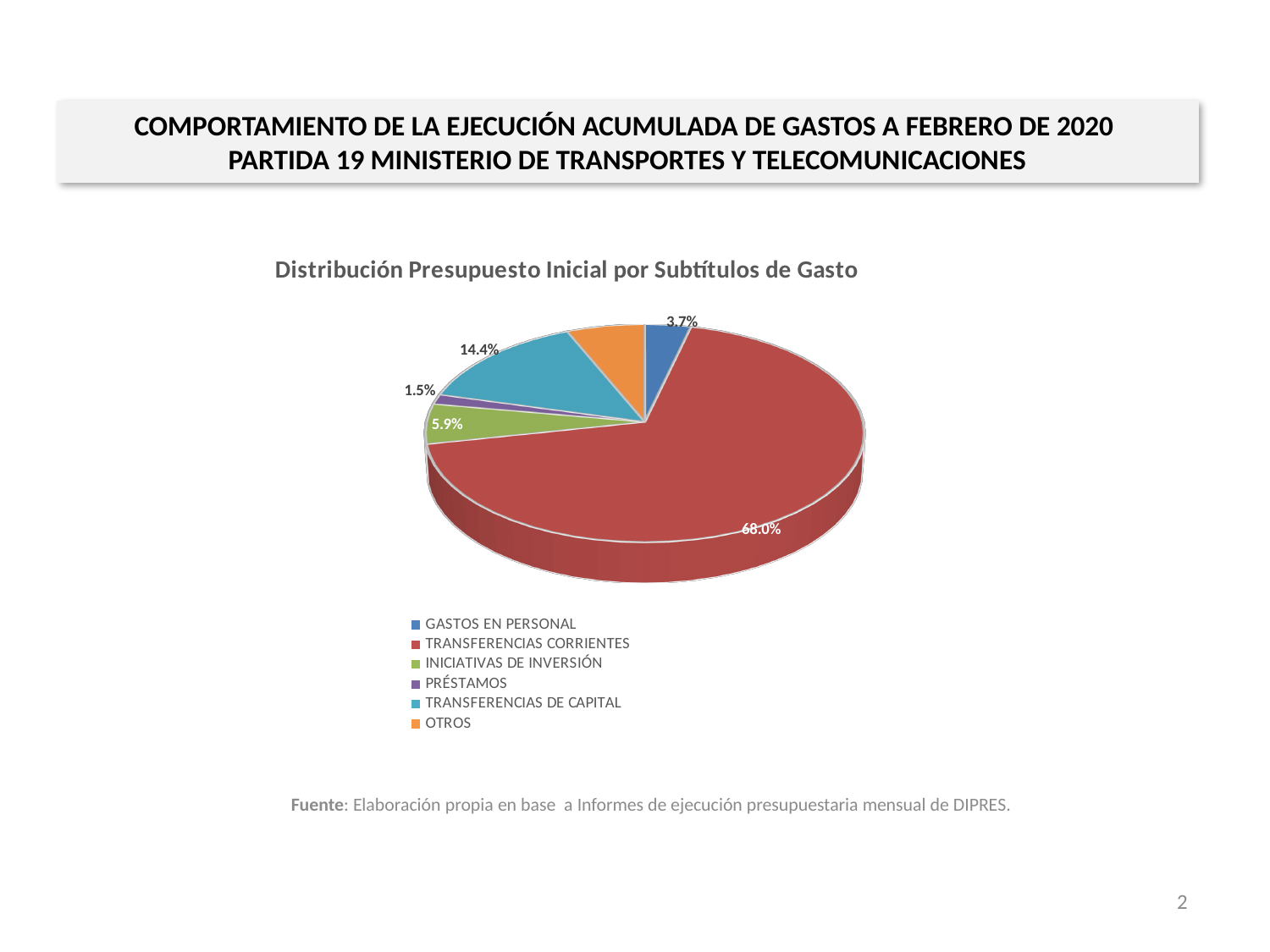
What percentage is shown for PRÉSTAMOS? 1.5% Which category has the smallest share of the pie? PRÉSTAMOS What share of the pie does TRANSFERENCIAS CORRIENTES represent? 68.0% What is the difference in percentage points between TRANSFERENCIAS CORRIENTES and TRANSFERENCIAS DE CAPITAL? 53.6 What type of chart is shown on the slide? Pie chart Which is larger, the share for INICIATIVAS DE INVERSIÓN or the share for GASTOS EN PERSONAL? INICIATIVAS DE INVERSIÓN What is the title of the chart? Distribución Presupuesto Inicial por Subtítulos de Gasto What percentage is shown for GASTOS EN PERSONAL? 3.7% How many categories does the legend list? 6 What percentage is shown for INICIATIVAS DE INVERSIÓN? 5.9% What percentage is shown for TRANSFERENCIAS DE CAPITAL? 14.4% Which category has the largest share of the pie? TRANSFERENCIAS CORRIENTES